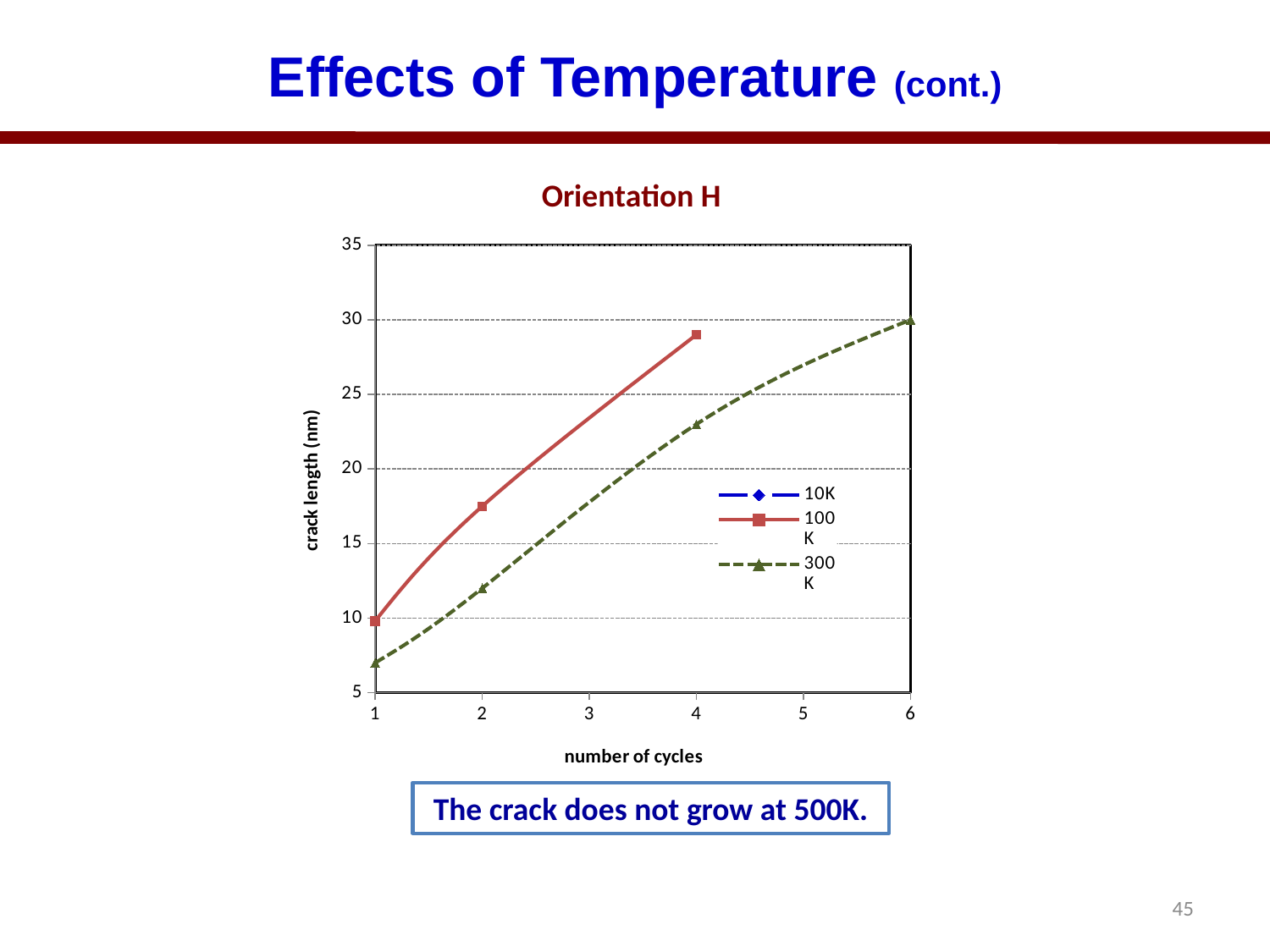
Is the crack length for the 300 K series at 4 cycles greater or less than 20? greater What is the title of the chart? Orientation H Is the crack length for the 300 K series at 2 cycles greater or less than 15? less Is the crack length for the 100 K series at 1 cycle greater or less than 15? less At 2 cycles, which series has the larger crack length, 100 K or 300 K? 100 K How many series does the legend list? 3 Which series has the highest crack length at 4 cycles? 100 K How many data points are plotted for the 300 K series? 4 Does the crack length for the 300 K series rise or fall as the number of cycles increases? rises What is the label of the y axis? crack length (nm) What kind of chart is shown on the slide? line chart